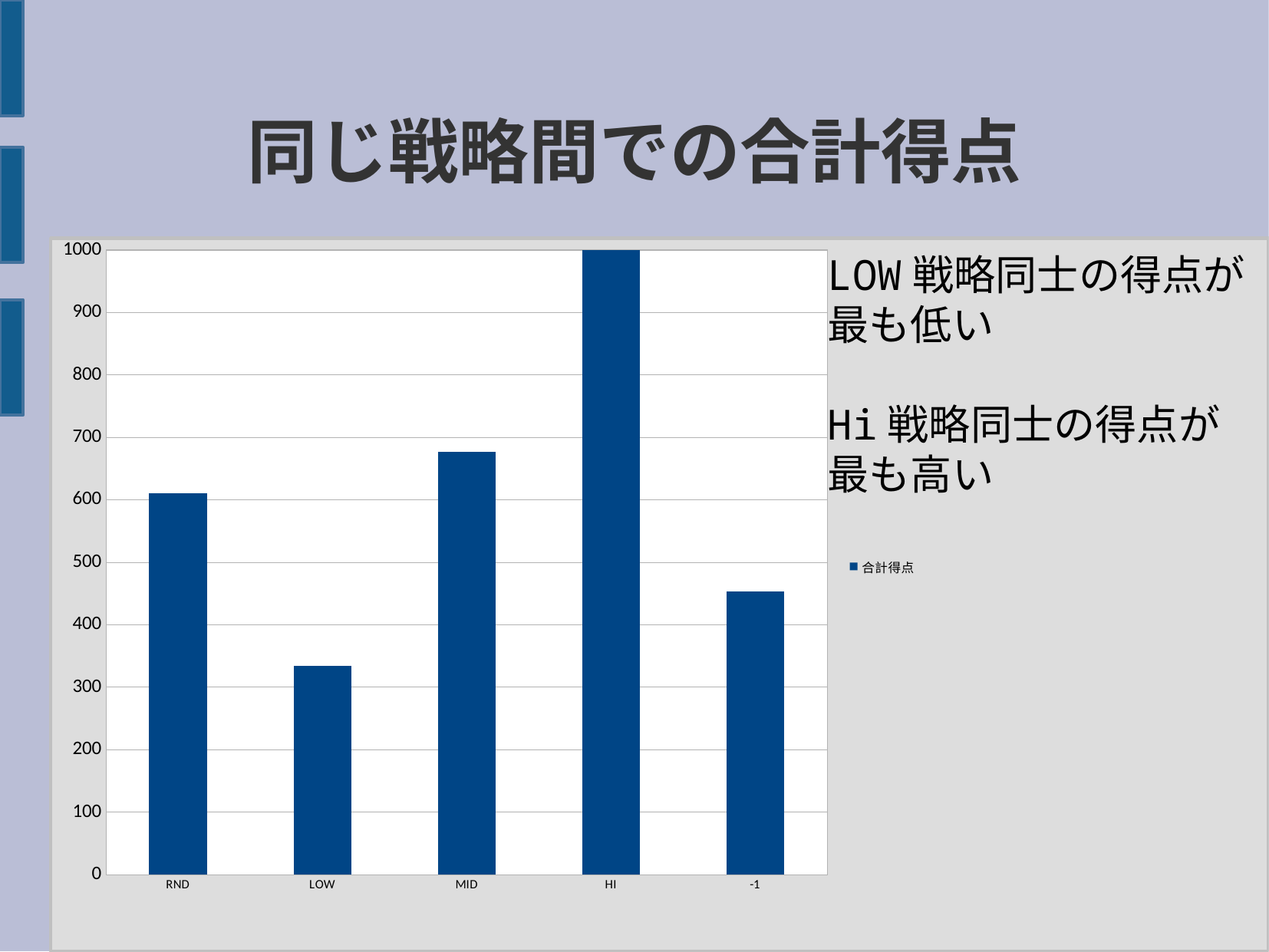
Is the value for MID greater or less than 700? less Is the value for LOW greater or less than 400? less How many categories are shown on the x axis of the chart? 5 What kind of chart is shown on the slide? bar chart Is the value for RND greater or less than 500? greater Which is larger, the value for MID or the value for RND? MID What is the name of the series listed in the chart's legend? 合計得点 How many series does the chart's legend list? 1 Which category has the highest bar in the chart? HI Which is larger, the value for RND or the value for -1? RND Which category has the lowest bar in the chart? LOW